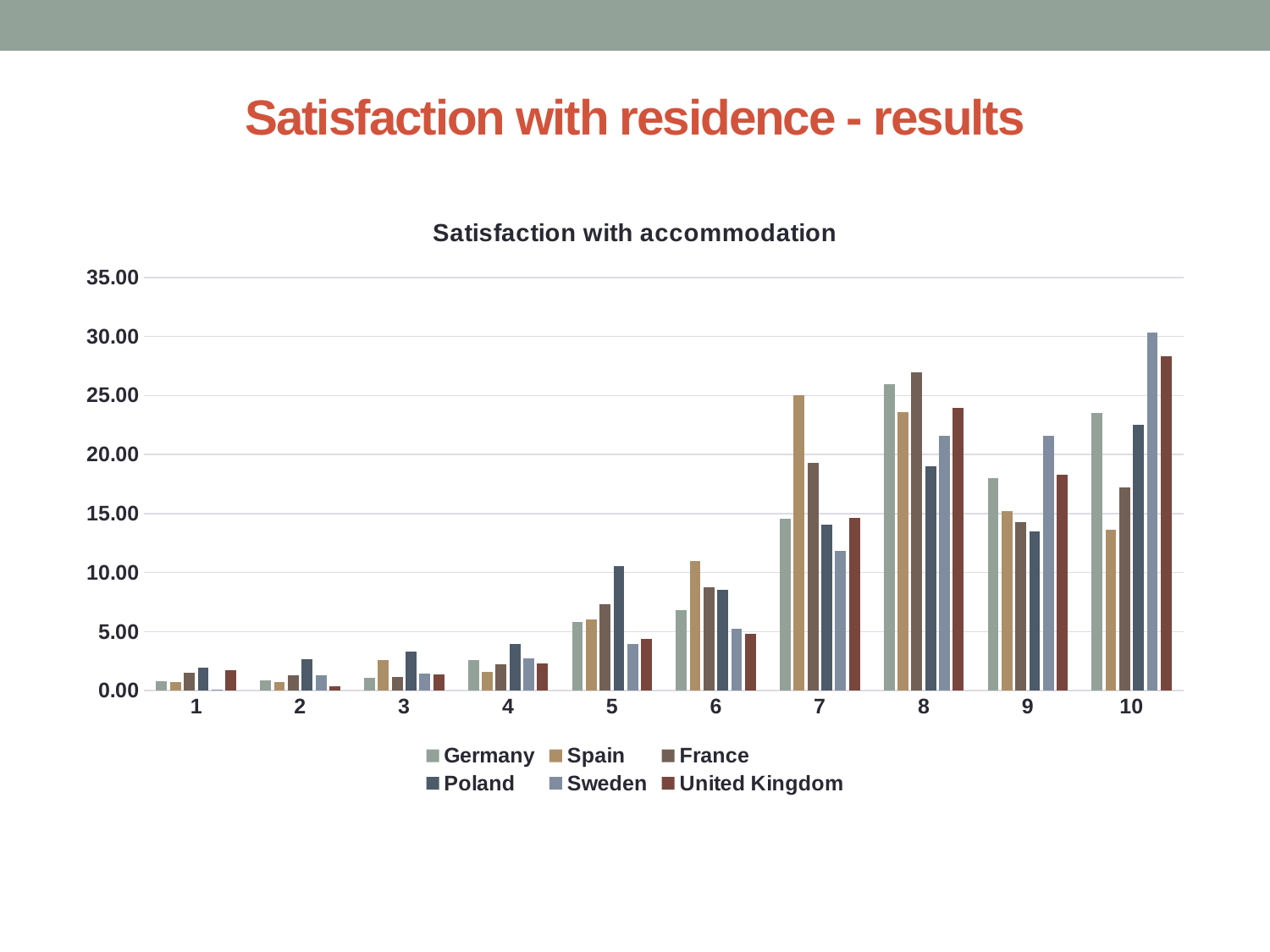
Which series has the highest value at category 10? Sweden Which series has the highest value at category 7? Spain What kind of chart is shown on the slide? bar chart Is the value for Sweden at category 7 greater or less than 15.00? less How many categories are shown along the x axis? 10 Do the values for Sweden generally rise or fall from category 1 to category 10? rise At category 9, which is larger: the value for Sweden or the value for Poland? Sweden Is the value for Sweden at category 10 greater or less than 25.00? greater Is the value for Spain at category 7 greater or less than 20.00? greater What is the title of the chart? Satisfaction with accommodation Which series has the lowest value at category 10? Spain How many series does the legend list? 6